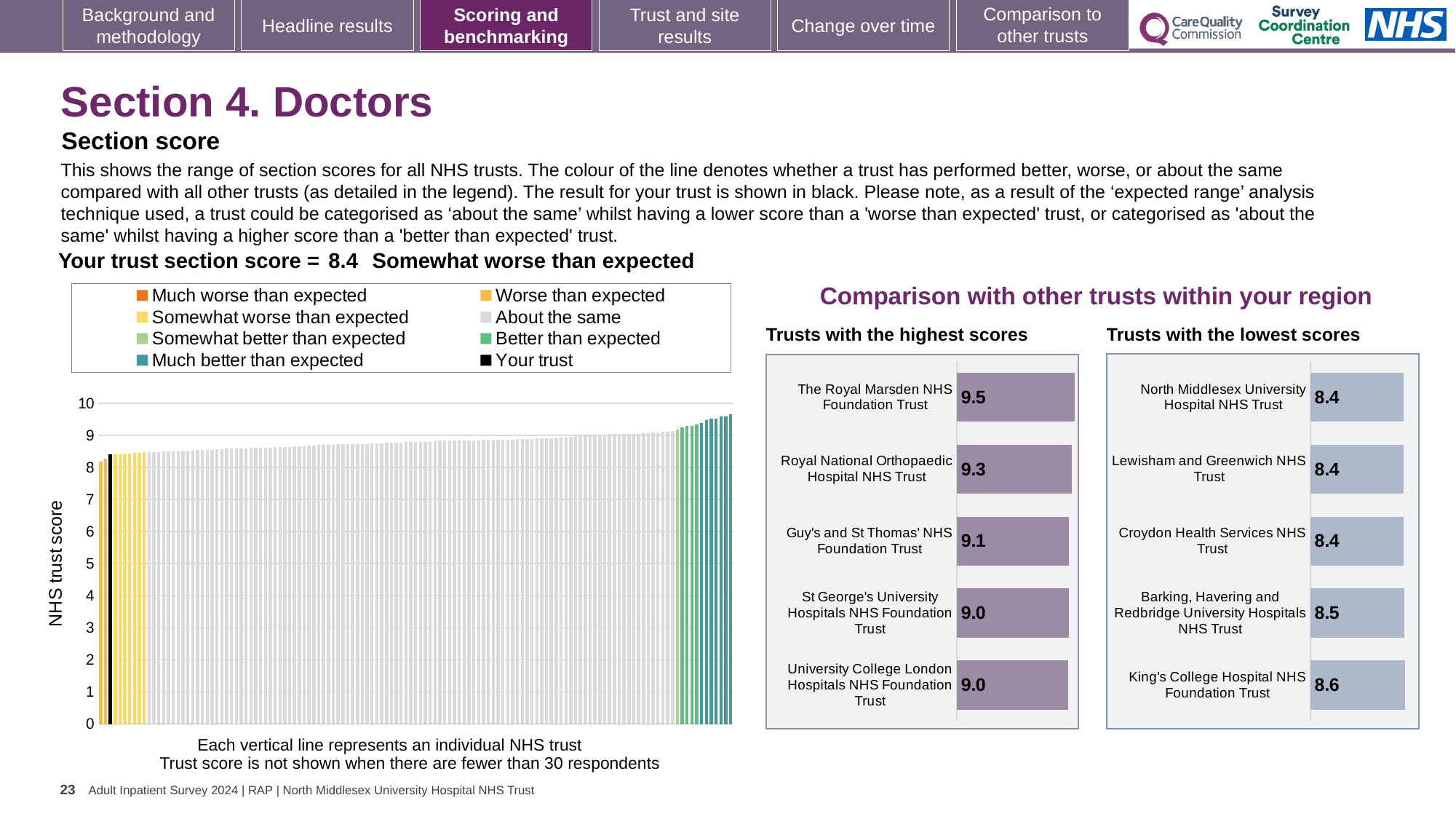
In the 'Trusts with the highest scores' chart, what is the difference between the scores of The Royal Marsden NHS Foundation Trust and Guy's and St Thomas' NHS Foundation Trust? 0.4 In the 'Trusts with the lowest scores' chart, which trust has the highest score? King's College Hospital NHS Foundation Trust Which is larger: the score for Royal National Orthopaedic Hospital NHS Trust in the 'Trusts with the highest scores' chart or the score for Barking, Havering and Redbridge University Hospitals NHS Trust in the 'Trusts with the lowest scores' chart? Royal National Orthopaedic Hospital NHS Trust In the large chart on the left, is the value of the tallest bar greater or less than 9? greater In the large chart on the left, do the bar heights rise or fall from left to right along the x axis? rise How many trusts are shown in the 'Trusts with the highest scores' chart? 5 In the 'Trusts with the lowest scores' chart, what is the score for King's College Hospital NHS Foundation Trust? 8.6 In the 'Trusts with the highest scores' chart, what is the score for The Royal Marsden NHS Foundation Trust? 9.5 In the 'Trusts with the highest scores' chart, which trust has the highest score? The Royal Marsden NHS Foundation Trust How many entries does the legend above the large chart on the left list? 8 What kind of chart is the large chart on the left showing NHS trust scores? bar chart In the large chart on the left, what is the section score for your trust (the black bar)? 8.4